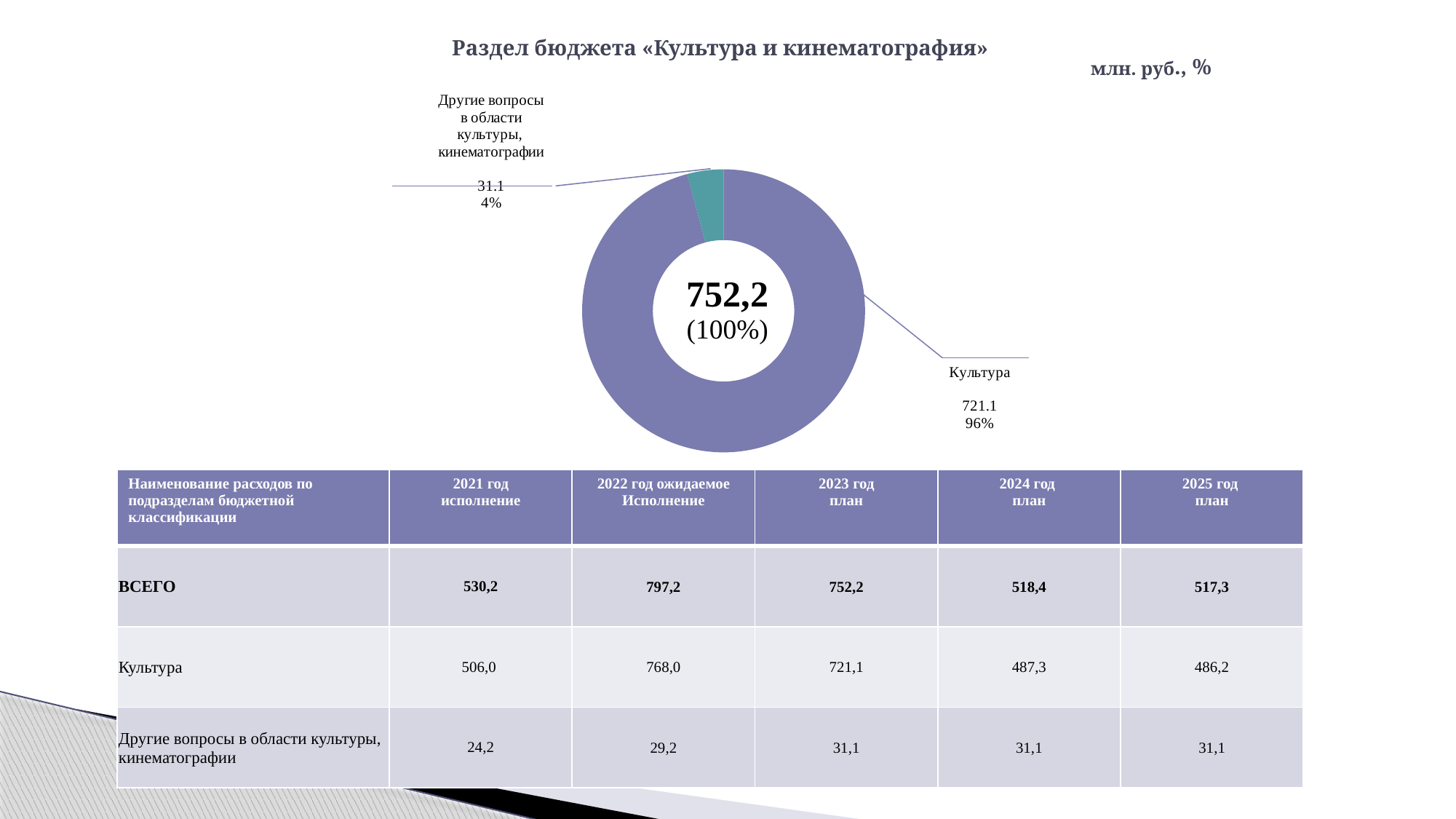
What is the value shown for Другие вопросы в области культуры, кинематографии in the donut chart? 31.1 What is the title of the chart on the slide? Раздел бюджета «Культура и кинематография» Which slice of the donut chart is the largest? Культура Which is larger in the donut chart: Культура or Другие вопросы в области культуры, кинематографии? Культура Which slice of the donut chart is the smallest? Другие вопросы в области культуры, кинематографии How many slices does the donut chart have? 2 What total value is shown in the centre of the donut chart? 752,2 What is the difference between the values for Культура and Другие вопросы в области культуры, кинематографии in the donut chart? 690.0 What share of the donut chart does Культура represent? 96% What is the value shown for Культура in the donut chart? 721.1 What share of the donut chart does Другие вопросы в области культуры, кинематографии represent? 4% What kind of chart is shown on the slide? Donut (pie) chart